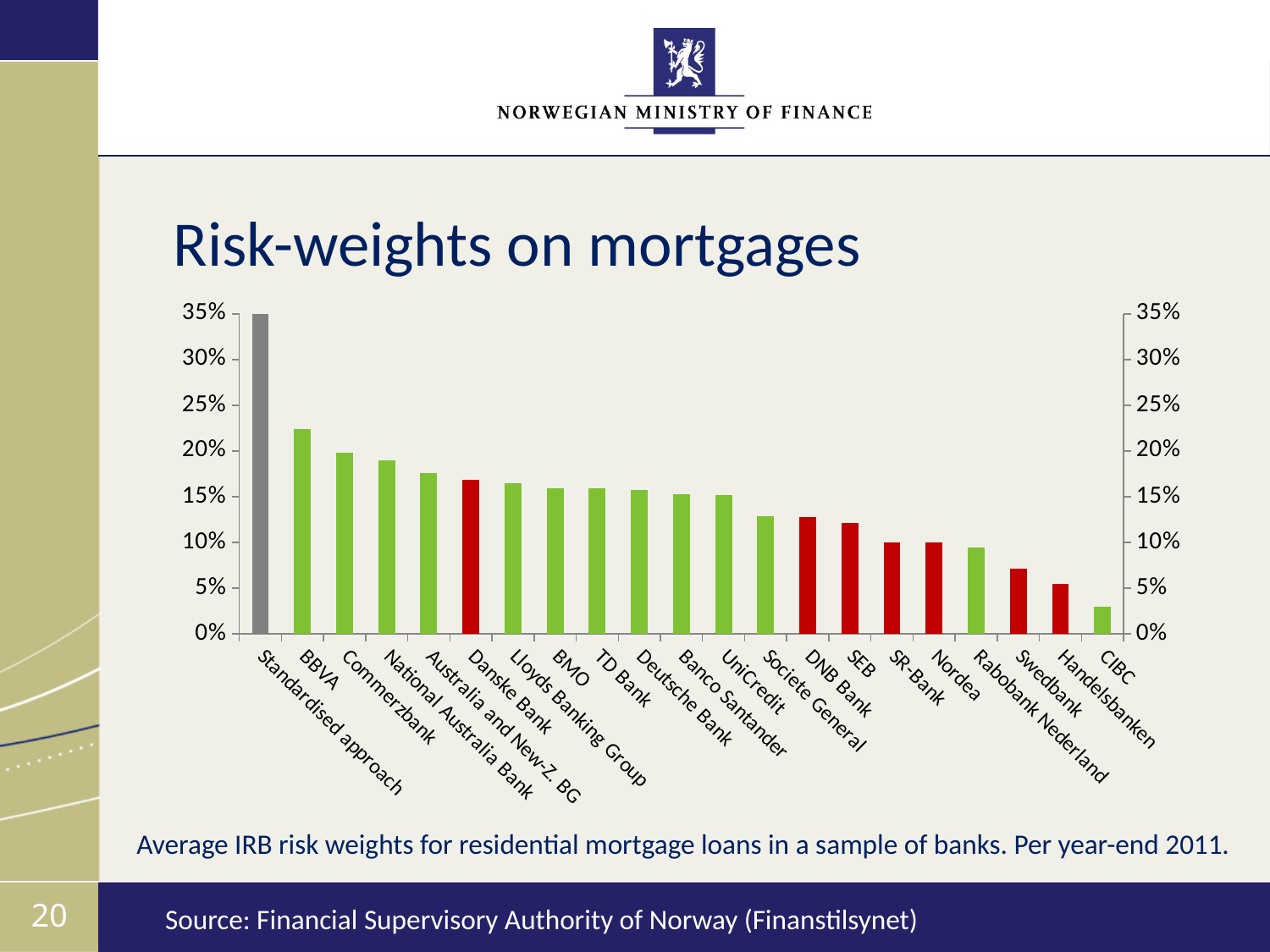
Which bank has the lowest risk weight in the chart? CIBC What is the title of the chart? Risk-weights on mortgages Which category has the highest risk weight in the chart? Standardised approach What kind of chart is shown on the slide? Bar chart Is the risk weight for Swedbank greater or less than 10%? less Which has a higher risk weight, BBVA or Commerzbank? BBVA Do the risk weights generally rise or fall moving from left to right along the x axis? Fall Is the risk weight for Danske Bank greater or less than 15%? greater How many bars (categories) are plotted in the chart? 21 What is the risk weight shown for the Standardised approach? 35% Is the risk weight for BBVA greater or less than 20%? greater